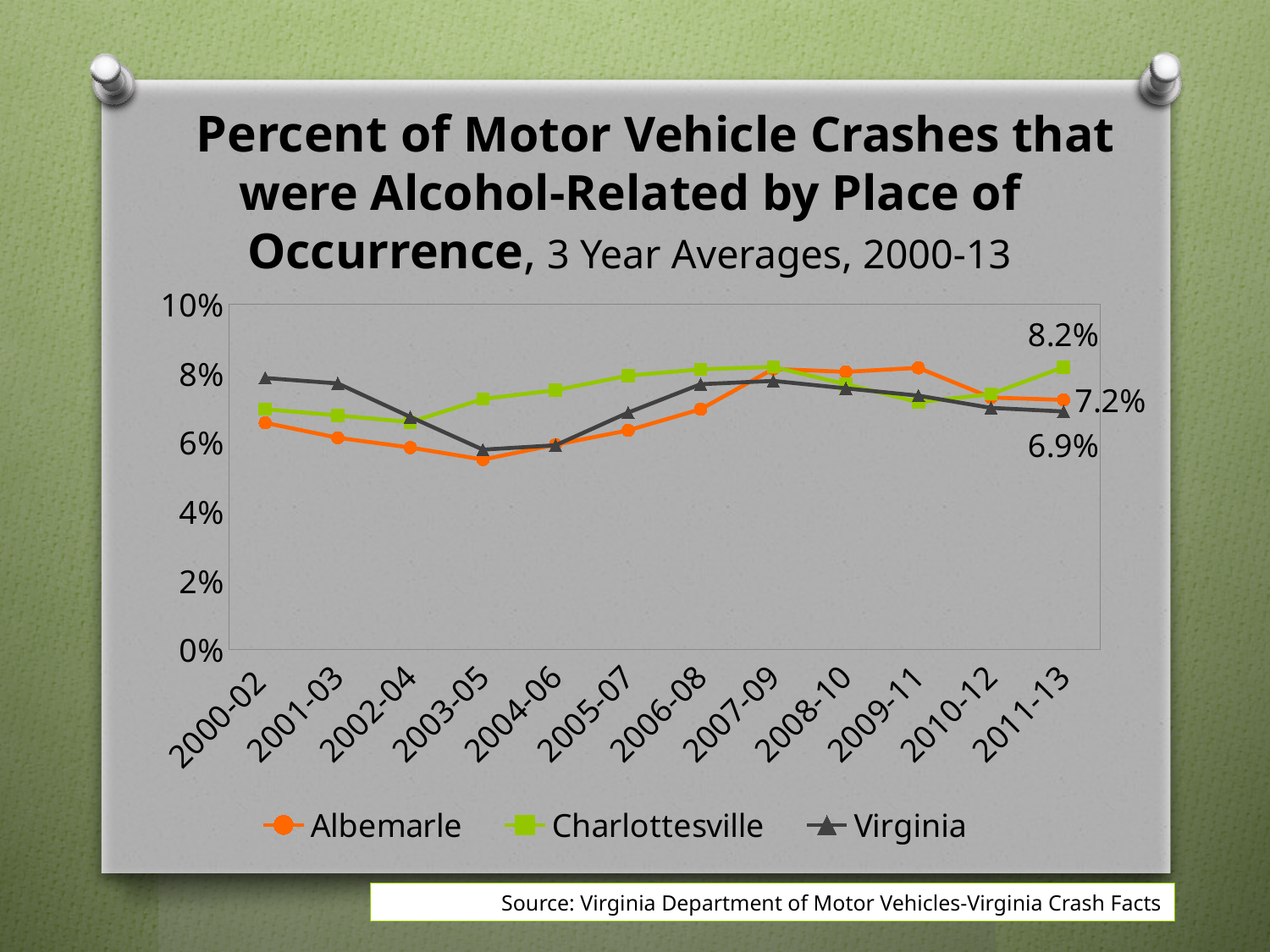
What is the value for Virginia in 2011-13? 6.9% Is the value for Albemarle in 2003-05 greater or less than 6%? less Which series has the highest value in 2011-13? Charlottesville How many series does the legend list? 3 What is the difference between the Charlottesville and Virginia values in 2011-13? 1.3 percentage points What is the value for Albemarle in 2011-13? 7.2% Which series has the lowest value in 2011-13? Virginia How many 3-year periods are shown along the x axis? 12 What is the value for Charlottesville in 2011-13? 8.2% Which series are listed in the legend? Albemarle, Charlottesville, Virginia Does the Albemarle line rise or fall from 2000-02 to 2003-05? fall What kind of chart is shown on the slide? line chart